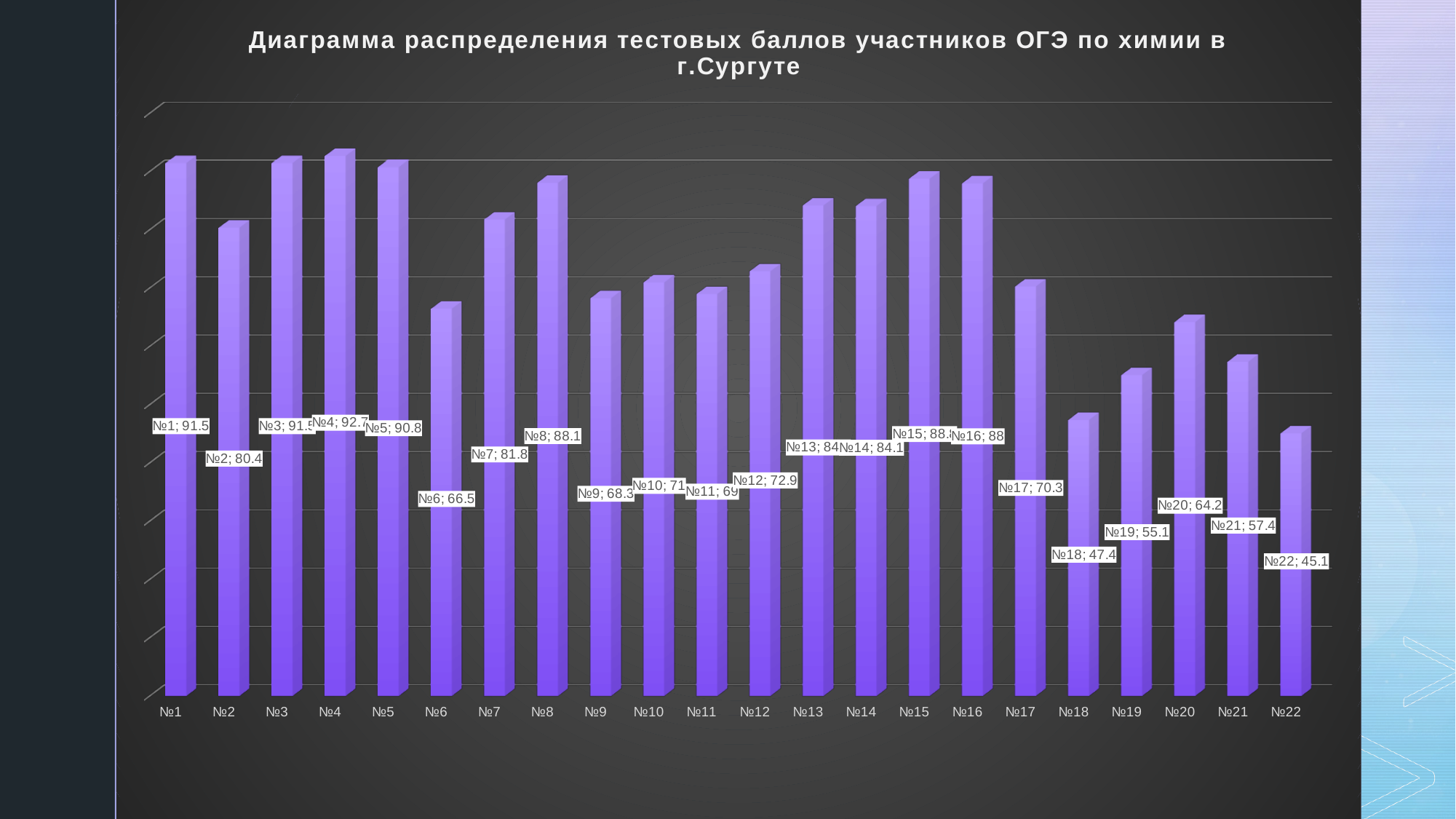
Which participant has the highest test score? №4 What is the title of the chart? Диаграмма распределения тестовых баллов участников ОГЭ по химии в г.Сургуте What kind of chart is shown on the slide? bar chart What is the difference between the scores of participant №16 and participant №17? 17.7 What is the test score for participant №12? 72.9 What is the test score for participant №4? 92.7 What is the test score for participant №16? 88 How many participants (categories) are shown on the x axis? 22 What is the difference between the scores of participant №1 and participant №2? 11.1 Which participant has the higher score, №7 or №8? №8 What is the test score for participant №18? 47.4 Which participant has the lowest test score? №22